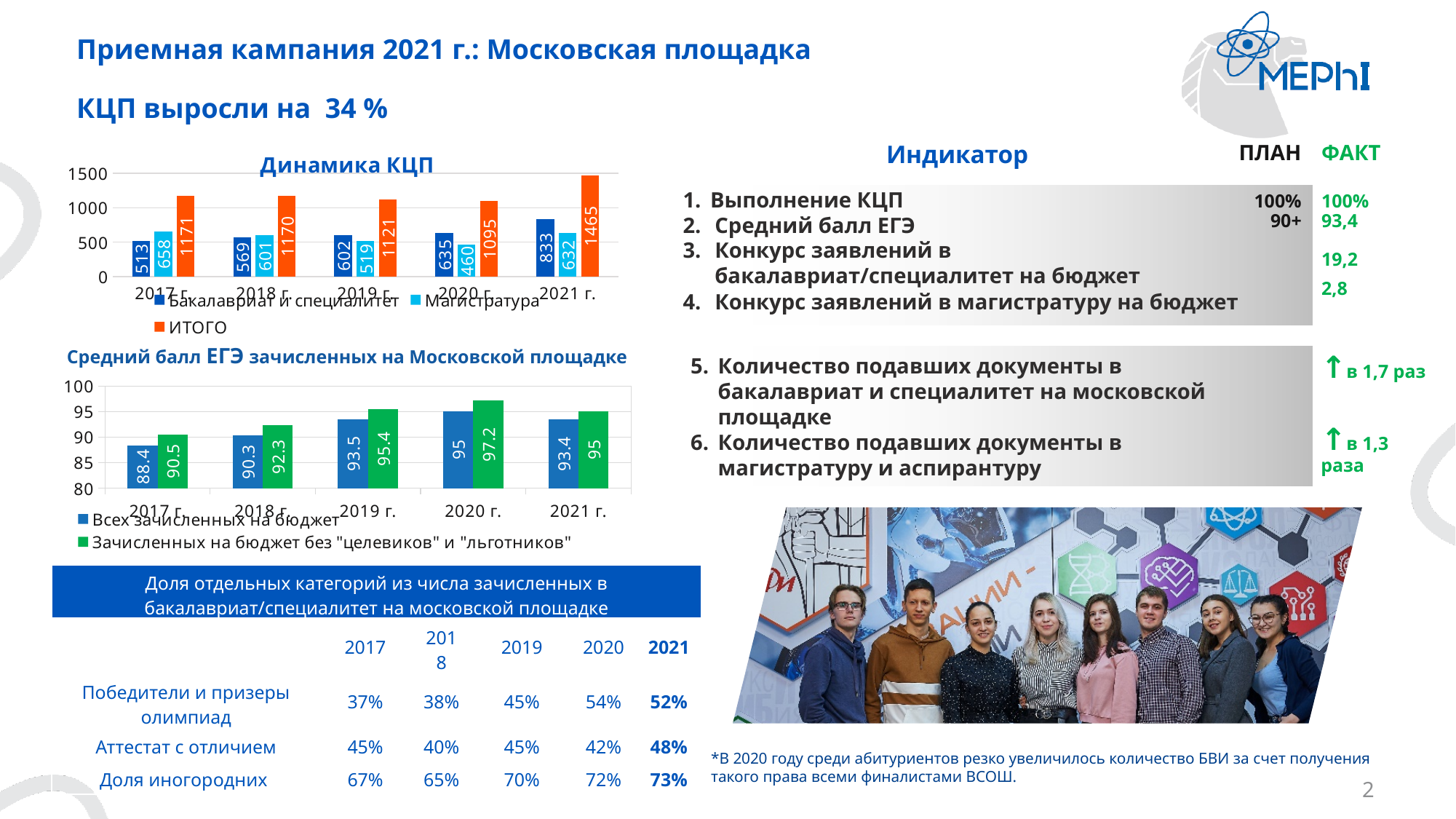
How many years are shown on the x axis of the "Средний балл ЕГЭ зачисленных на Московской площадке" chart? 5 In the "Средний балл ЕГЭ зачисленных на Московской площадке" chart, what is the difference between the two series in 2017 г.? 2.1 In the "Динамика КЦП" chart, what is the value of Магистратура for 2020 г.? 460 In the "Средний балл ЕГЭ зачисленных на Московской площадке" chart, what is the value for Всех зачисленных на бюджет in 2019 г.? 93.5 What type of chart is "Динамика КЦП"? Bar chart In the "Динамика КЦП" chart, which year has the highest ИТОГО value? 2021 г. In the "Средний балл ЕГЭ зачисленных на Московской площадке" chart, which is larger in 2018 г.: Всех зачисленных на бюджет or Зачисленных на бюджет без "целевиков" и "льготников"? Зачисленных на бюджет без "целевиков" и "льготников" In the "Средний балл ЕГЭ зачисленных на Московской площадке" chart, which year has the highest value for Зачисленных на бюджет без "целевиков" и "льготников"? 2020 г. In the "Динамика КЦП" chart, what is the difference between the ИТОГО values for 2021 г. and 2020 г.? 370 In the "Динамика КЦП" chart, what is the value of ИТОГО for 2021 г.? 1465 In the "Динамика КЦП" chart, how many series does the legend list? 3 In the "Динамика КЦП" chart, which year has the lowest value for Бакалавриат и специалитет? 2017 г.